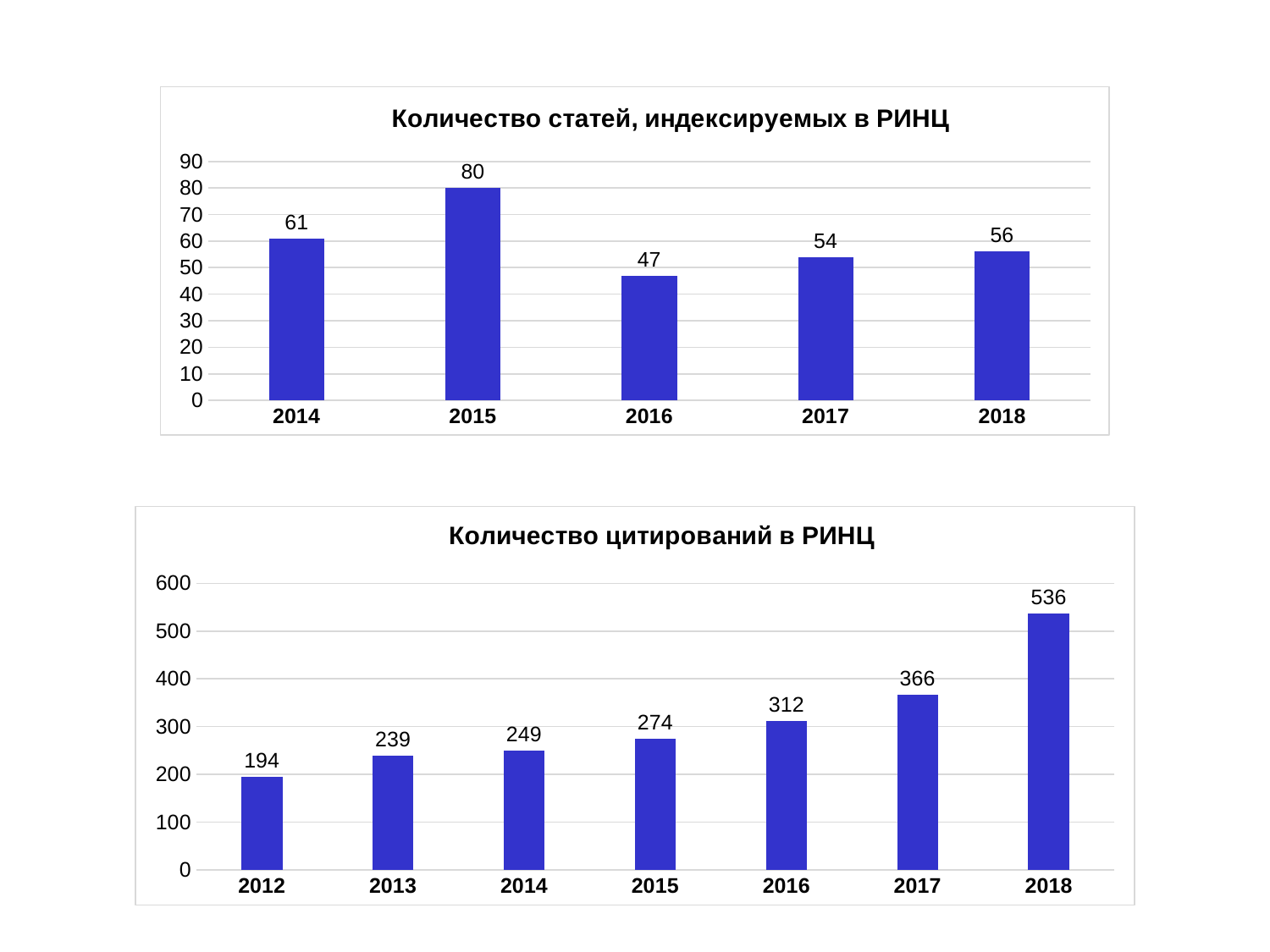
In the chart 'Количество статей, индексируемых в РИНЦ', what is the value for 2015? 80 What is the title of the top chart on the slide? Количество статей, индексируемых в РИНЦ What kind of chart is the bottom chart on the slide? bar chart In the chart 'Количество цитирований в РИНЦ', how many years are shown on the x axis? 7 In the chart 'Количество статей, индексируемых в РИНЦ', which year has the lowest value? 2016 In the chart 'Количество статей, индексируемых в РИНЦ', which is larger, the value for 2014 or the value for 2018? 2014 In the chart 'Количество статей, индексируемых в РИНЦ', what is the difference between the values for 2015 and 2016? 33 In the chart 'Количество статей, индексируемых в РИНЦ', how many years are shown on the x axis? 5 In the chart 'Количество цитирований в РИНЦ', what is the difference between the values for 2018 and 2017? 170 In the chart 'Количество цитирований в РИНЦ', which year has the highest value? 2018 In the chart 'Количество цитирований в РИНЦ', do the values rise or fall from 2012 to 2018? rise In the chart 'Количество цитирований в РИНЦ', what is the value for 2017? 366